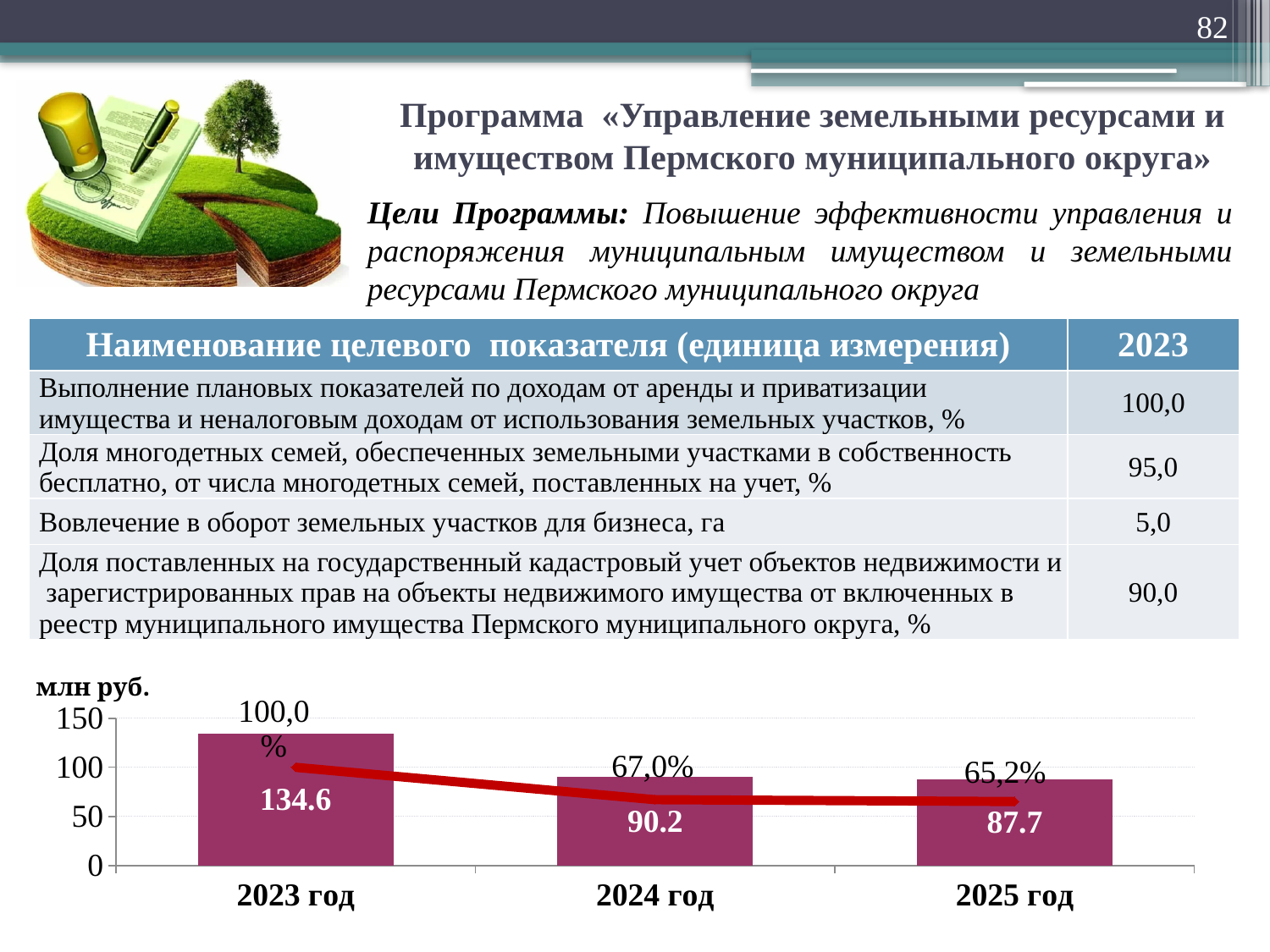
What percentage is shown on the line for 2025 год? 65,2% What percentage is shown on the line for 2024 год? 67,0% Is the bar value for 2023 год greater or less than 100? greater What is the value for 2023 год in the bar chart? 134.6 What is the difference between the bar values for 2023 год and 2024 год? 44.4 What is the value for 2024 год in the bar chart? 90.2 Do the bar values rise or fall from 2023 год to 2025 год? fall How many years are shown on the x axis of the chart? 3 Which is larger, the bar value for 2024 год or for 2025 год? 2024 год Which year has the lowest bar value? 2025 год What is the value for 2025 год in the bar chart? 87.7 Which year has the highest bar value? 2023 год